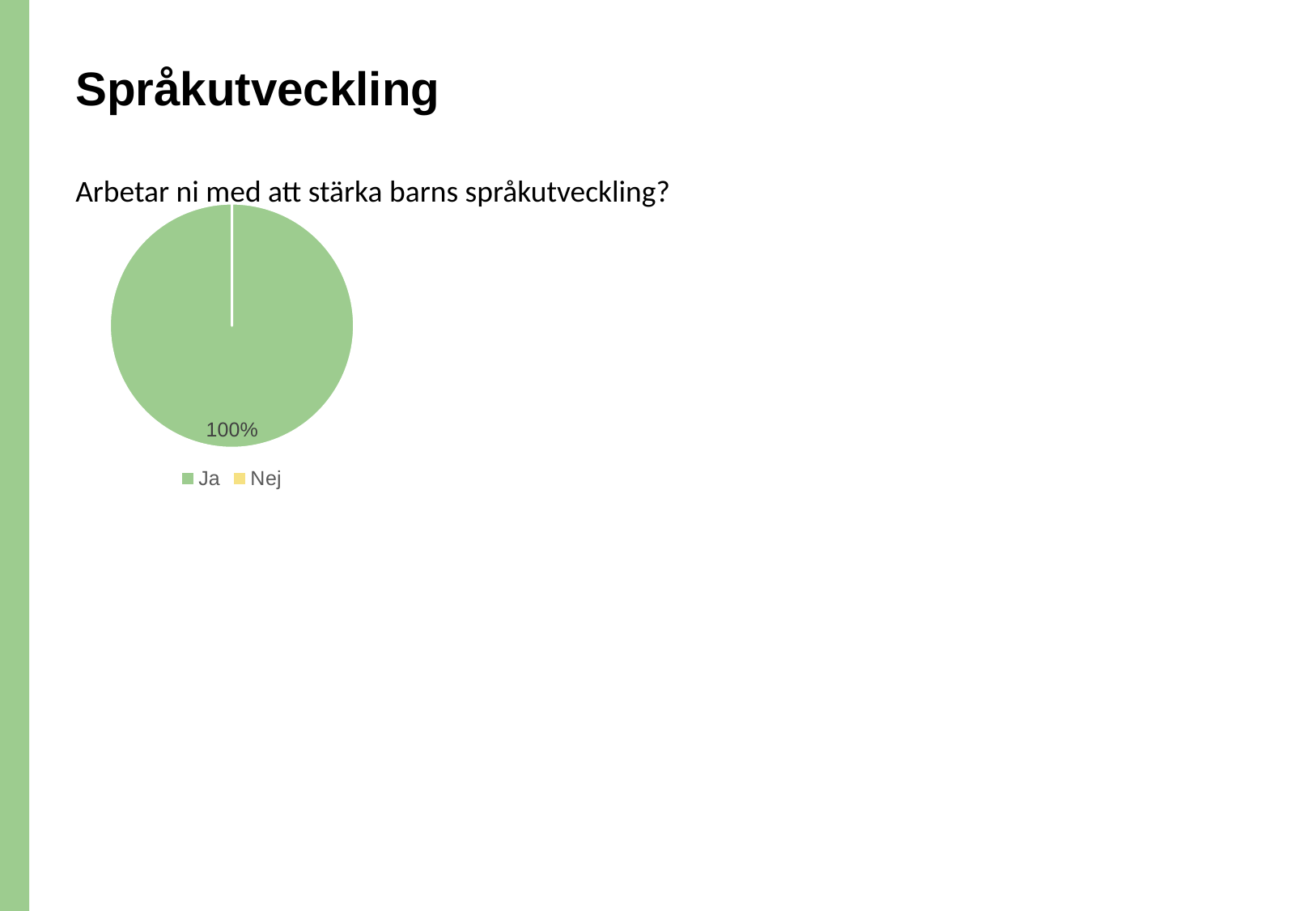
Which category has the smallest share of the pie? Nej What question does the chart answer, as written above it? Arbetar ni med att stärka barns språkutveckling? Which category has the largest share of the pie? Ja What is the only data label printed on the pie chart? 100% What share of the pie does "Ja" represent? 100% Which is larger, the share for "Ja" or the share for "Nej"? Ja How many categories does the legend list? 2 What colour represents "Ja" in the legend? green What kind of chart is shown on the slide? pie chart